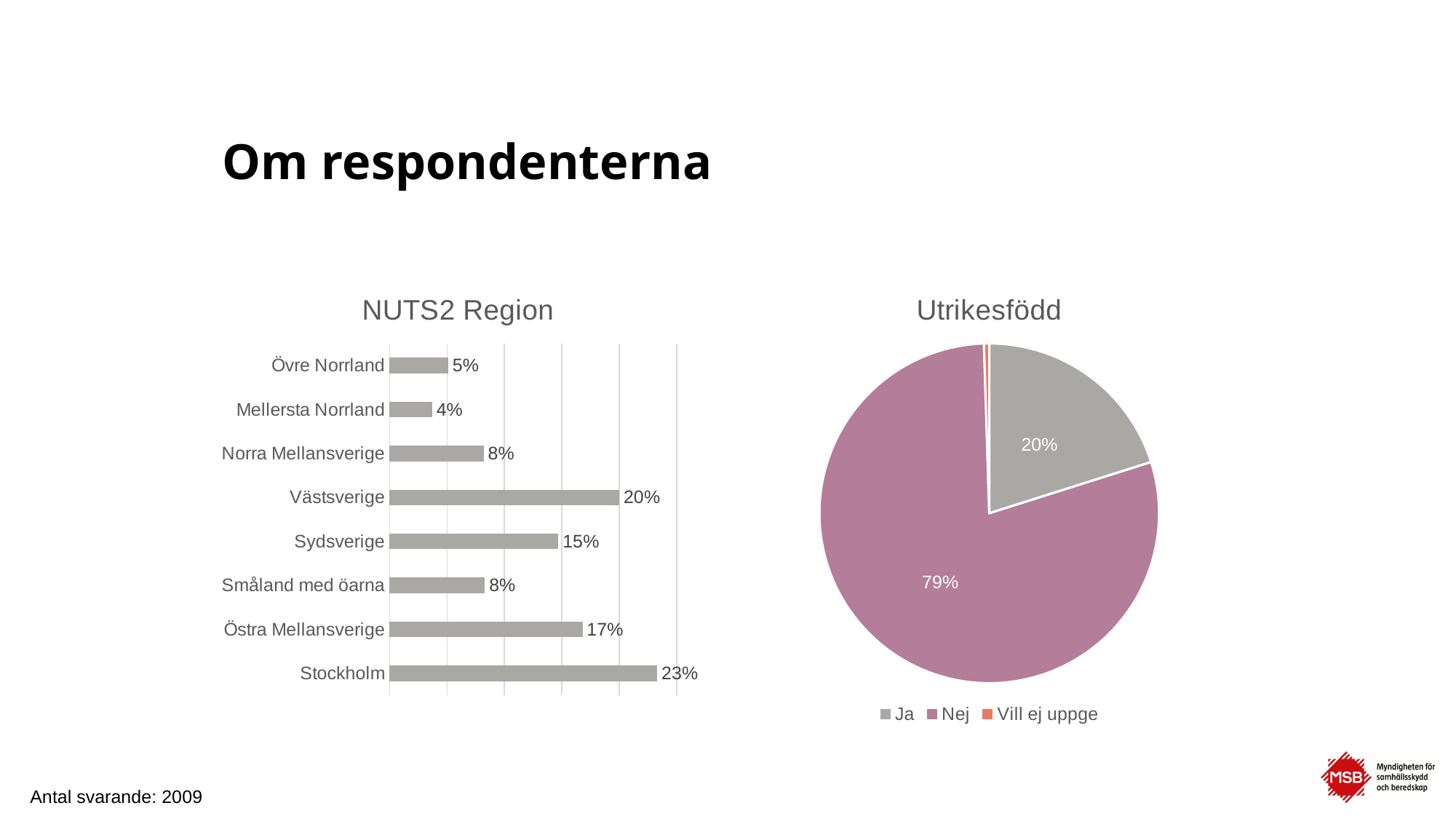
In the NUTS2 Region chart, which region has the highest value? Stockholm How many entries does the legend of the Utrikesfödd chart list? 3 In the Utrikesfödd chart, what share of the pie is Ja? 20% In the NUTS2 Region chart, what is the value for Mellersta Norrland? 4% In the Utrikesfödd chart, what share of the pie is Nej? 79% What kind of chart is the NUTS2 Region chart? Bar chart In the NUTS2 Region chart, what is the value for Stockholm? 23% How many regions are shown in the NUTS2 Region chart? 8 In the NUTS2 Region chart, which region has the lowest value? Mellersta Norrland In the NUTS2 Region chart, which is larger, Sydsverige or Norra Mellansverige? Sydsverige In the NUTS2 Region chart, what is the difference between Stockholm and Östra Mellansverige? 6% In the NUTS2 Region chart, what is the value for Västsverige? 20%